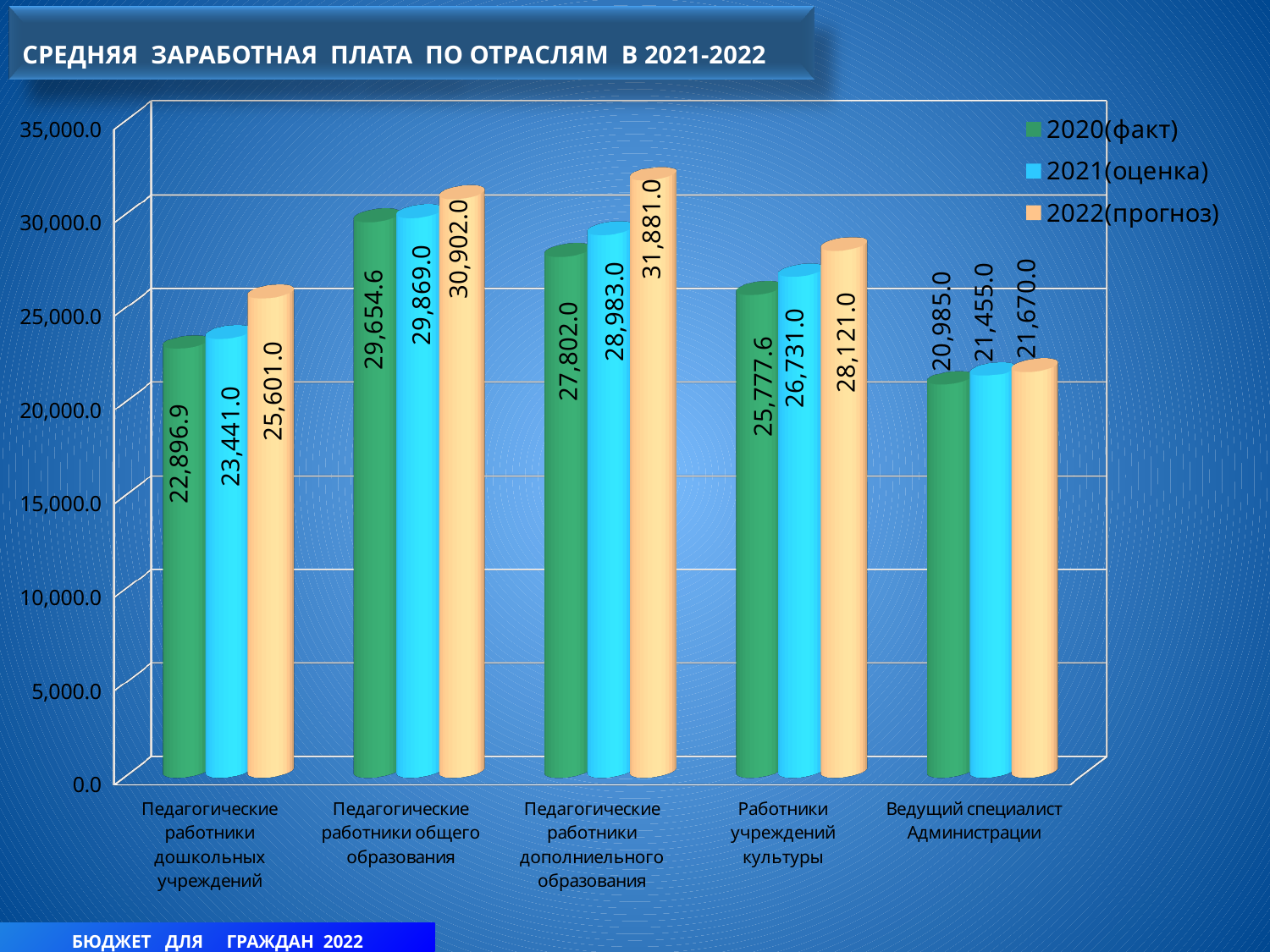
What is the difference between the 2022(прогноз) and 2020(факт) values for Педагогические работники дополниельного образования? 4,079.0 How many series does the legend list? 3 What kind of chart is shown on the slide? bar chart Which category has the lowest 2020(факт) value? Ведущий специалист Администрации Which category has the highest 2022(прогноз) value? Педагогические работники дополниельного образования What is the 2020(факт) value for Педагогические работники дошкольных учреждений? 22,896.9 Is the 2021(оценка) value for Педагогические работники дошкольных учреждений greater or less than 25,000.0? less What is the 2022(прогноз) value for Ведущий специалист Администрации? 21,670.0 What is the 2021(оценка) value for Работники учреждений культуры? 26,731.0 How many categories are shown on the x axis? 5 What is the title of the slide? СРЕДНЯЯ ЗАРАБОТНАЯ ПЛАТА ПО ОТРАСЛЯМ В 2021-2022 Which is larger: the 2022(прогноз) value for Педагогические работники общего образования or for Педагогические работники дополниельного образования? Педагогические работники дополниельного образования